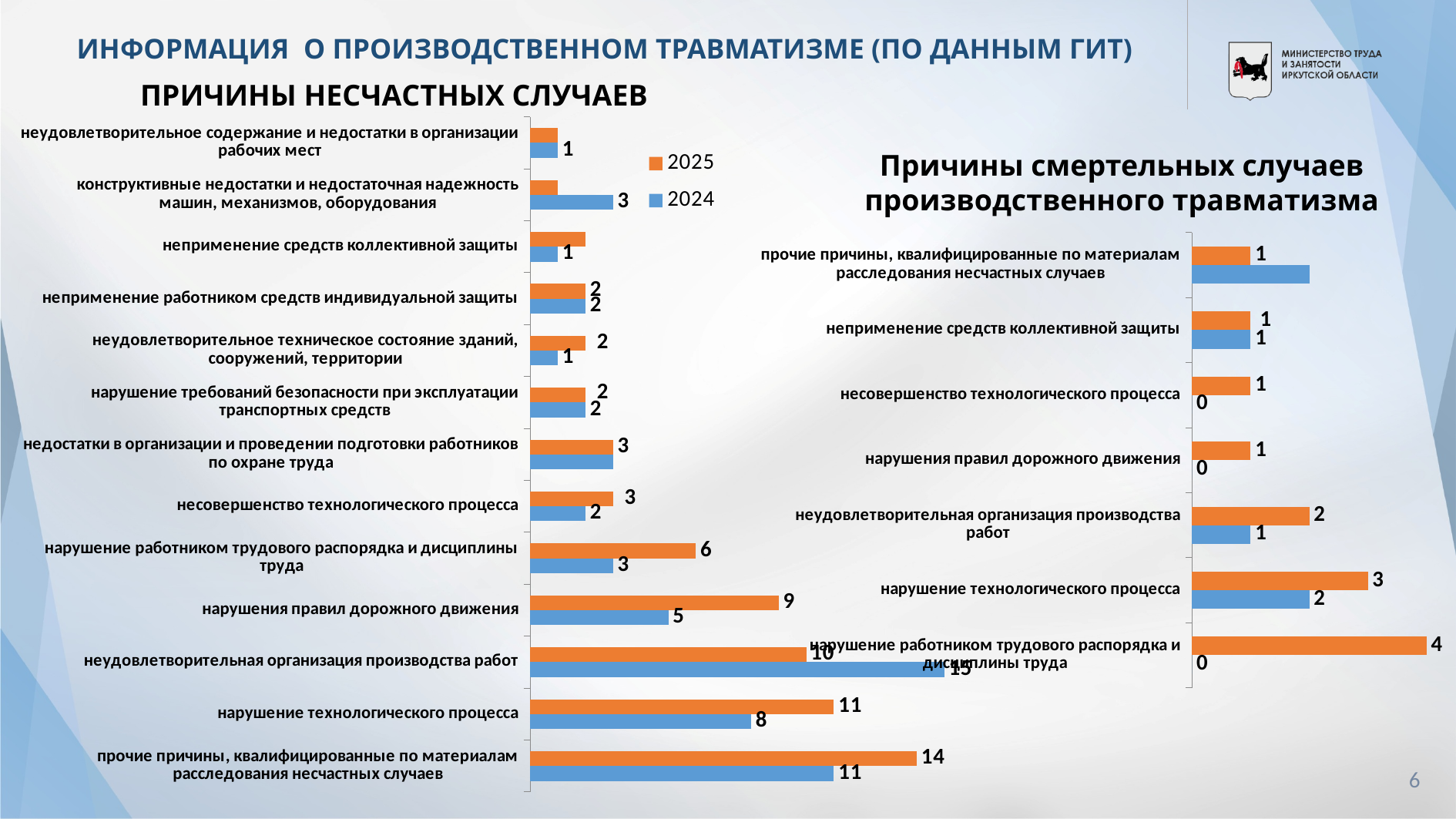
In the chart 'ПРИЧИНЫ НЕСЧАСТНЫХ СЛУЧАЕВ', which is larger for 'нарушение работником трудового распорядка и дисциплины труда': the 2025 value or the 2024 value? 2025 In the chart 'ПРИЧИНЫ НЕСЧАСТНЫХ СЛУЧАЕВ', what is the 2025 value for 'прочие причины, квалифицированные по материалам расследования несчастных случаев'? 14 How many categories are shown in the chart 'ПРИЧИНЫ НЕСЧАСТНЫХ СЛУЧАЕВ'? 13 In the chart 'ПРИЧИНЫ НЕСЧАСТНЫХ СЛУЧАЕВ', what is the 2024 value for 'неудовлетворительная организация производства работ'? 15 In the chart 'Причины смертельных случаев производственного травматизма', what is the 2025 value for 'нарушение работником трудового распорядка и дисциплины труда'? 4 How many categories are shown in the chart 'Причины смертельных случаев производственного травматизма'? 7 What type of chart is 'Причины смертельных случаев производственного травматизма'? bar chart In the chart 'ПРИЧИНЫ НЕСЧАСТНЫХ СЛУЧАЕВ', what is the 2024 value for 'нарушения правил дорожного движения'? 5 In the chart 'ПРИЧИНЫ НЕСЧАСТНЫХ СЛУЧАЕВ', which category has the highest 2025 value? прочие причины, квалифицированные по материалам расследования несчастных случаев In the chart 'Причины смертельных случаев производственного травматизма', what is the 2024 value for 'нарушение технологического процесса'? 2 In the chart 'ПРИЧИНЫ НЕСЧАСТНЫХ СЛУЧАЕВ', what is the difference between the 2025 and 2024 values for 'нарушение технологического процесса'? 3 How many series does the legend of the chart 'ПРИЧИНЫ НЕСЧАСТНЫХ СЛУЧАЕВ' list? 2